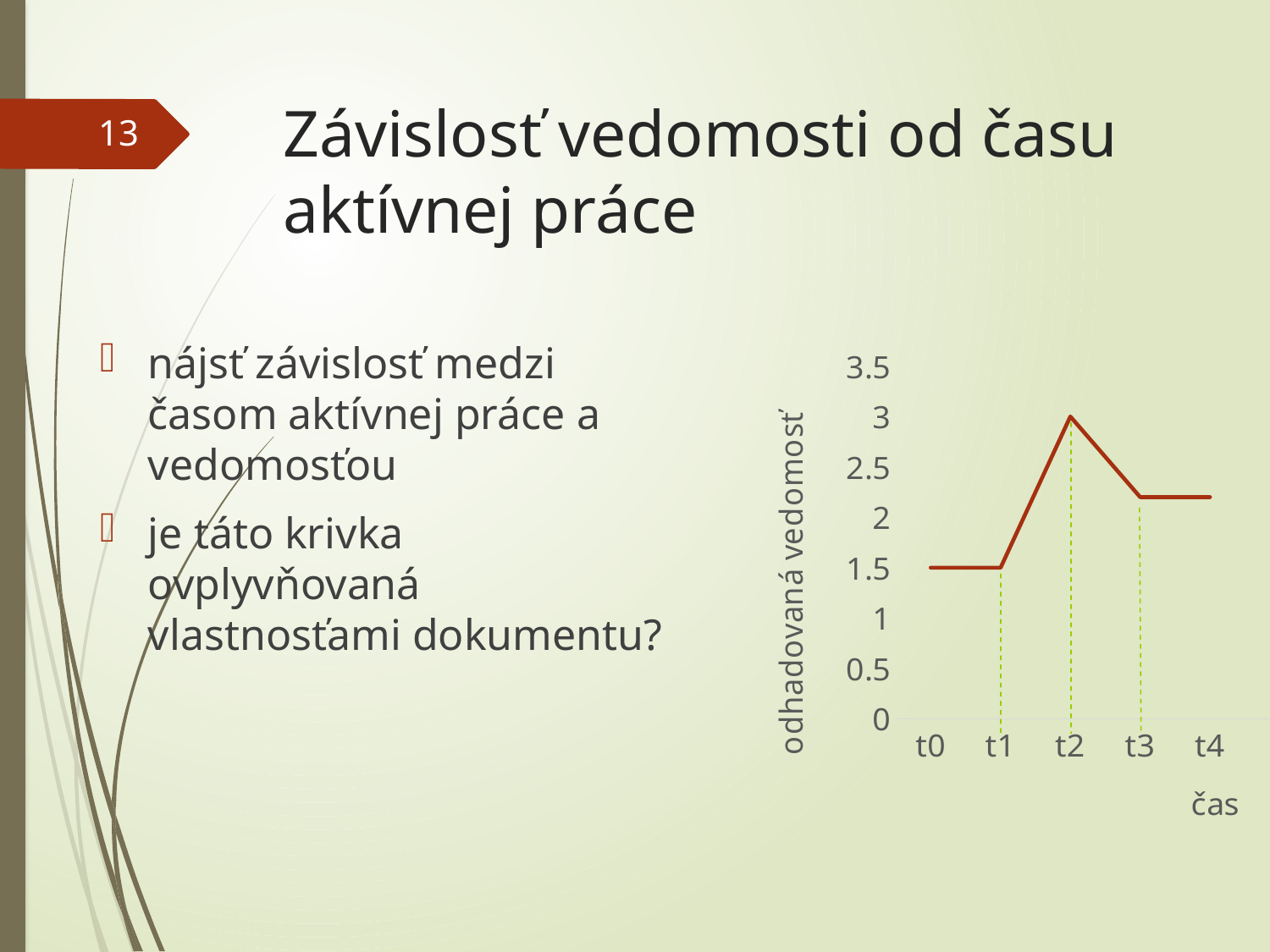
Which is larger, the value at t2 or the value at t3? t2 What is the difference between the value at t2 and the value at t1? 1.5 Is the value at t2 greater or less than 2? greater Does the line rise or fall between t2 and t3? fall How many points are plotted along the x axis of the chart? 5 What is the value of the line at t2? 3 At which time point does the line reach its highest value? t2 What is the value of the line at t0? 1.5 What is the label of the vertical axis of the chart? odhadovaná vedomosť What kind of chart is shown on the slide? line chart What is the label of the horizontal axis of the chart? čas